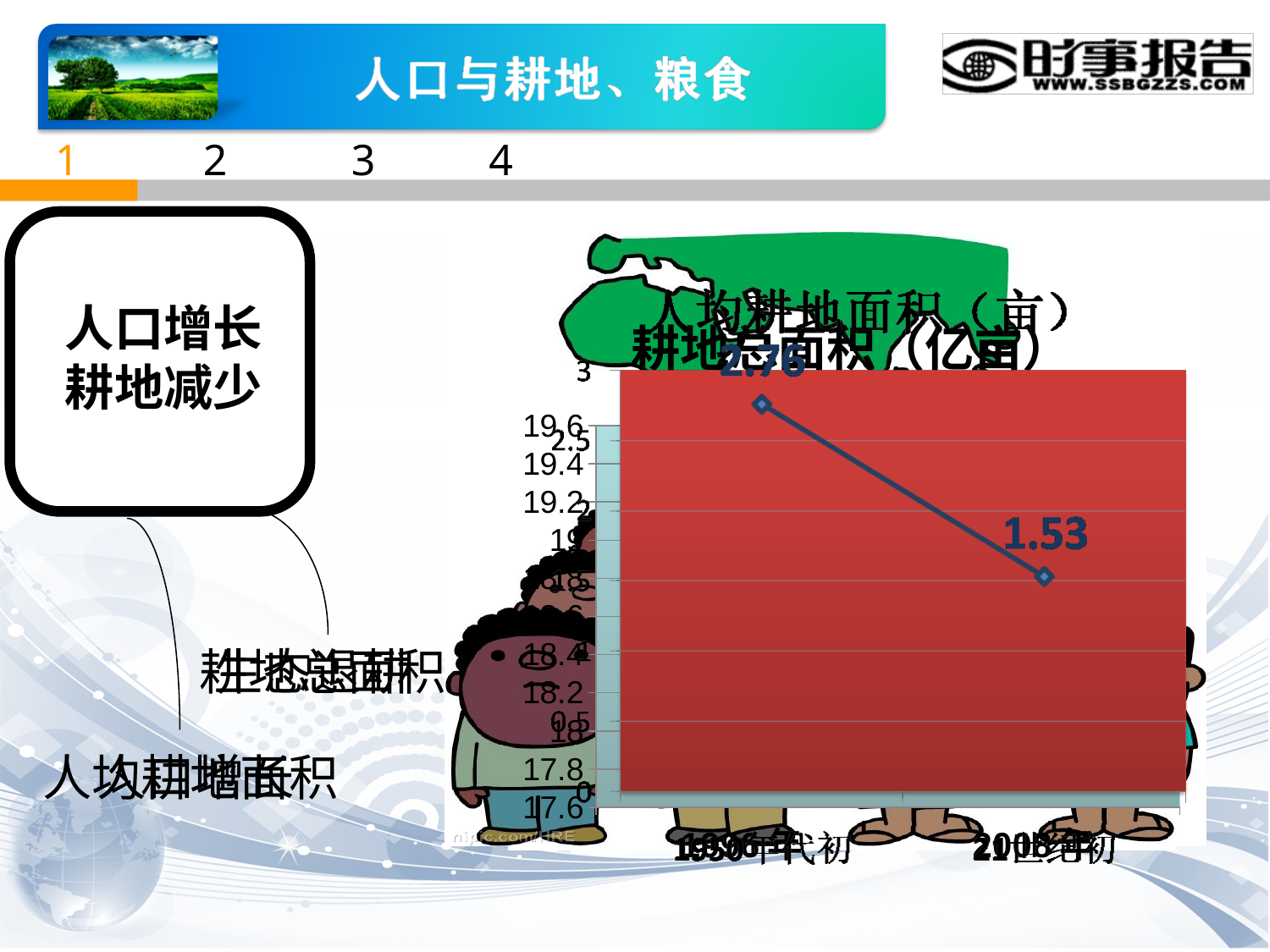
In the chart titled 人均耕地面积（亩）, is the value of the second data point greater or less than 2? less What kind of chart is the chart titled 人均耕地面积（亩）? line chart In the chart titled 人均耕地面积（亩）, what is the lowest plotted value? 1.53 In the chart titled 人均耕地面积（亩）, what is the highest plotted value? 2.76 How many data points are plotted on the line in the chart titled 人均耕地面积（亩）? 2 In the chart titled 人均耕地面积（亩）, what is the difference between the first and second data points? 1.23 In the chart titled 人均耕地面积（亩）, do the values rise or fall from left to right? fall In the chart titled 人均耕地面积（亩）, what is the value of the first (left) data point? 2.76 In the chart titled 人均耕地面积（亩）, is the value of the first data point greater or less than 2.5? greater In the chart titled 人均耕地面积（亩）, what is the value of the second (right) data point? 1.53 In the chart titled 人均耕地面积（亩）, which data point is larger, the first or the second? the first What colour is the plot area background of the line chart showing the values 2.76 and 1.53? red